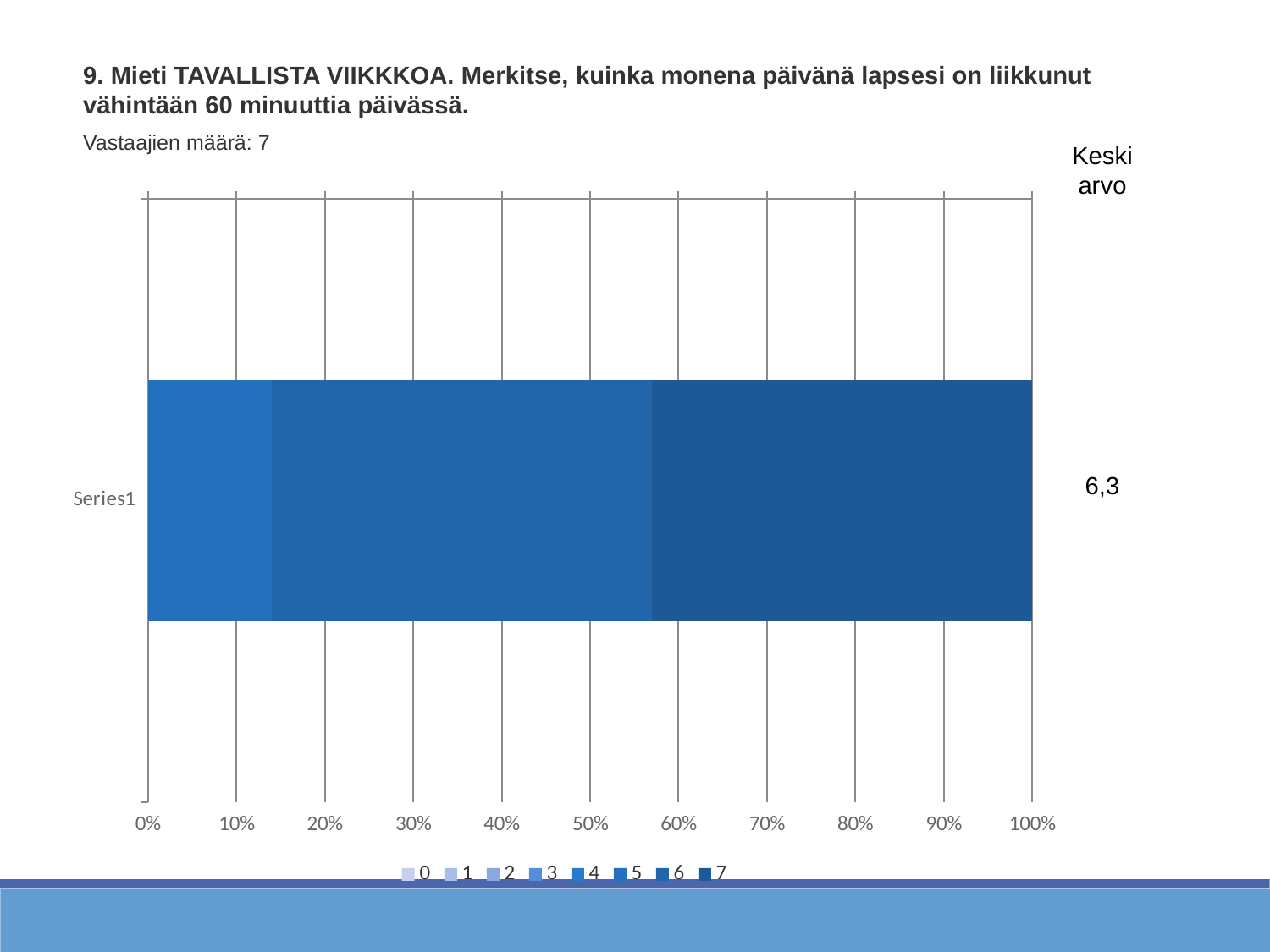
What kind of chart is shown on the slide? bar chart Which of the three visible segments of the Series1 bar is the narrowest: the leftmost, the middle, or the rightmost? the leftmost How many categories are plotted on the vertical axis? 1 What is the highest value shown on the horizontal axis? 100% How many series does the legend list? 8 What is the Keskiarvo (mean) value shown next to the chart? 6,3 Is the width of the middle segment of the Series1 bar greater or less than 30%? greater Does the Series1 bar end at 100% on the horizontal axis? Yes What is the number of respondents (Vastaajien määrä) stated on the slide? 7 Is the width of the first (leftmost) segment of the Series1 bar greater or less than 10%? greater Is the width of the first (leftmost) segment of the Series1 bar greater or less than 20%? less What is the label of the single category on the vertical axis? Series1